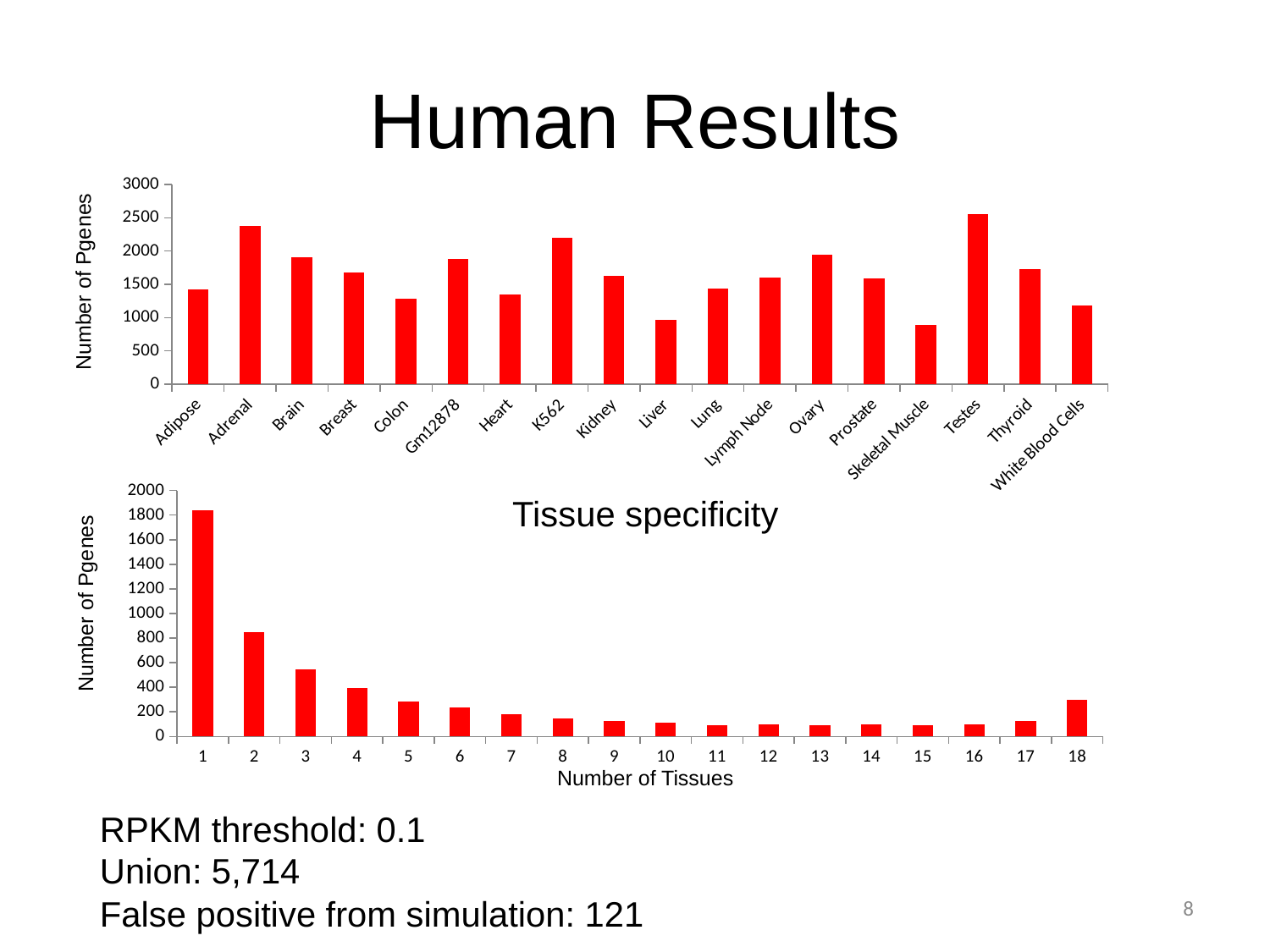
What kind of chart is the top chart on the slide? bar chart In the top chart, how many tissues are shown on the x axis? 18 In the Tissue specificity chart, how many categories are on the x axis? 18 In the top chart, which tissue has the highest number of Pgenes? Testes In the top chart, is the value for Liver greater or less than 1000? less In the top chart, which has more Pgenes, Ovary or Prostate? Ovary In the top chart, which has more Pgenes, Adrenal or Brain? Adrenal In the Tissue specificity chart, is the value for 18 tissues greater or less than 200? greater In the top chart, is the value for Adipose greater or less than 1500? less In the Tissue specificity chart, which number of tissues has the highest number of Pgenes? 1